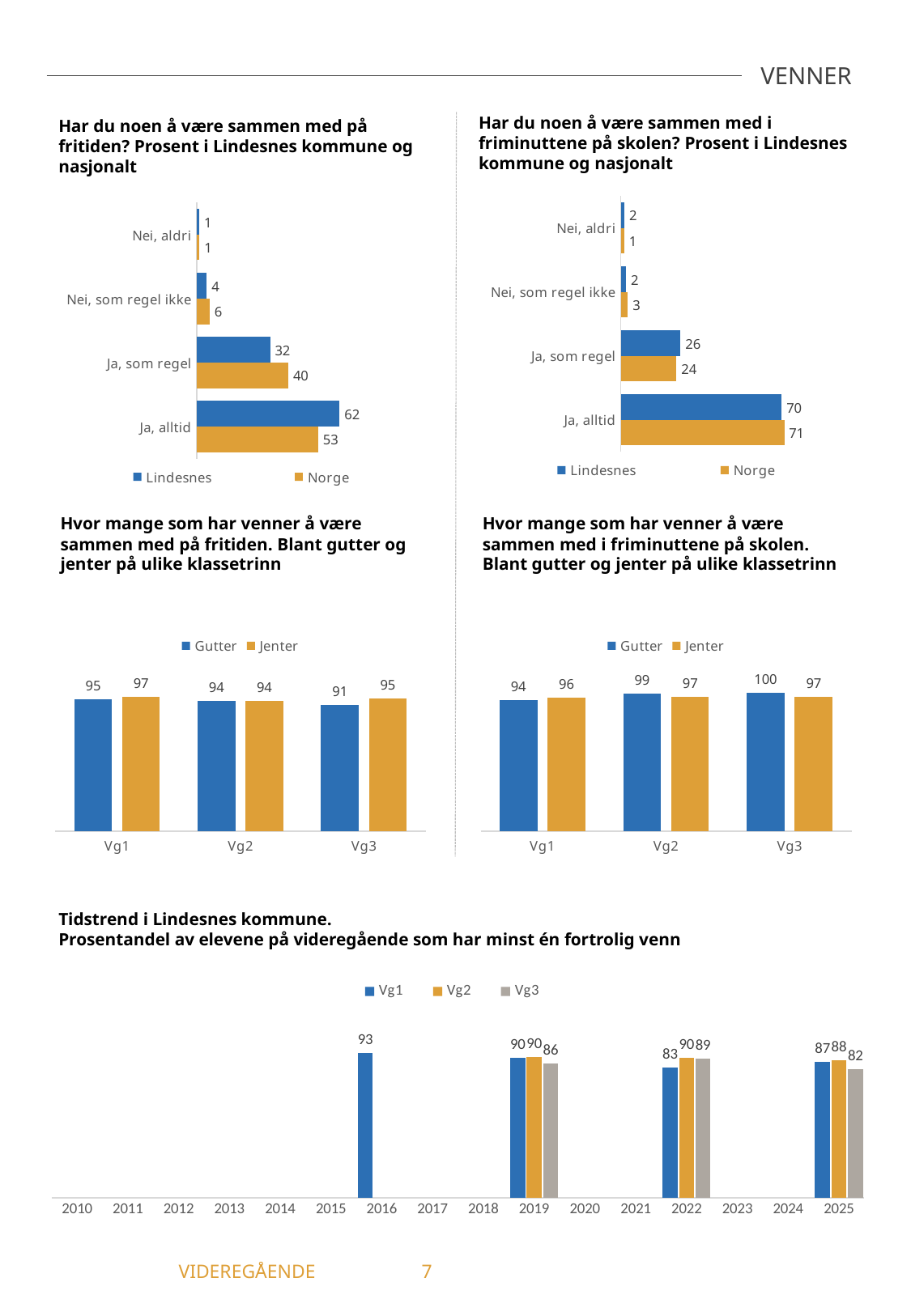
In the bottom chart (Tidstrend i Lindesnes kommune), what is the Vg3 value for 2025? 82 In the middle-right chart (Hvor mange som har venner å være sammen med i friminuttene på skolen), how many class levels are shown on the x axis? 3 In the top-left chart (Har du noen å være sammen med på fritiden?), what is the difference between the Norge and Lindesnes values for 'Ja, som regel'? 8 In the bottom chart (Tidstrend i Lindesnes kommune), what is the Vg1 value for 2016? 93 In the middle-left chart (Hvor mange som har venner å være sammen med på fritiden), what is the Jenter value for Vg3? 95 In the top-right chart (Har du noen å være sammen med i friminuttene på skolen?), what is the Norge value for 'Ja, alltid'? 71 In the top-right chart (Har du noen å være sammen med i friminuttene på skolen?), which category has the highest Lindesnes value? Ja, alltid In the top-right chart (Har du noen å være sammen med i friminuttene på skolen?), how many series does the legend list? 2 In the top-left chart (Har du noen å være sammen med på fritiden?), what is the Lindesnes value for 'Ja, alltid'? 62 In the middle-left chart (Hvor mange som har venner å være sammen med på fritiden), which is larger for Vg1: Gutter or Jenter? Jenter What type of chart is the bottom chart (Tidstrend i Lindesnes kommune)? Bar chart In the middle-right chart (Hvor mange som har venner å være sammen med i friminuttene på skolen), what is the Gutter value for Vg3? 100